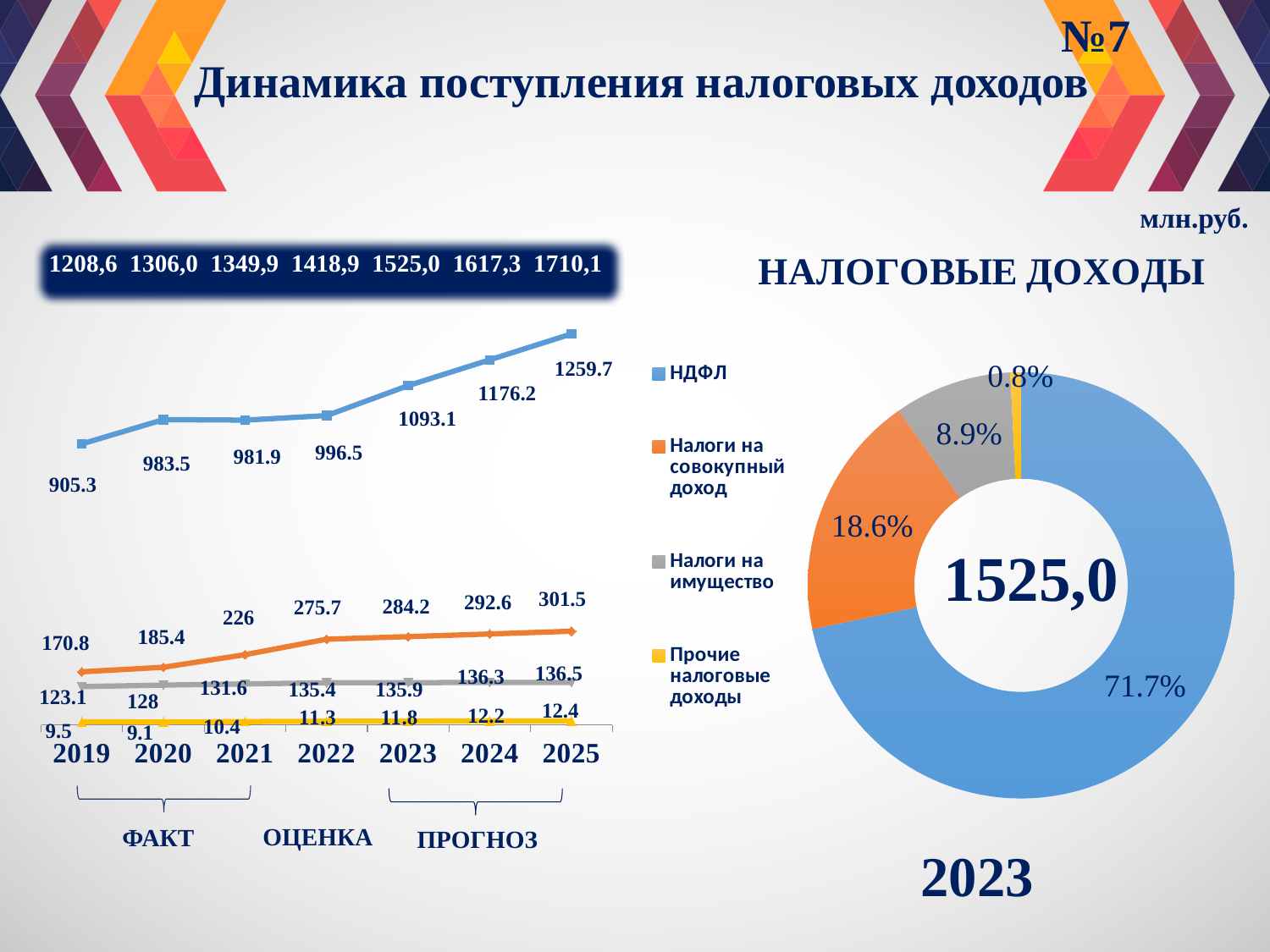
On the line chart, what is the value for Налоги на совокупный доход in 2025? 301.5 On the line chart, what is the value for Прочие налоговые доходы in 2020? 9.1 On the line chart, how many years are shown on the x axis? 7 What kind of chart is the chart on the left of the slide? line chart On the line chart, by how much does НДФЛ in 2025 exceed НДФЛ in 2019? 354.4 On the line chart, what is the value for НДФЛ in 2023? 1093.1 On the line chart, in which year is Прочие налоговые доходы lowest? 2020 On the line chart, in which year is НДФЛ highest? 2025 On the line chart, which is larger: НДФЛ in 2020 or in 2021? 2020 On the line chart, do the values for Налоги на совокупный доход rise or fall from 2019 to 2025? rise On the НАЛОГОВЫЕ ДОХОДЫ donut chart, what share does НДФЛ have? 71.7% How many series does the legend list? 4